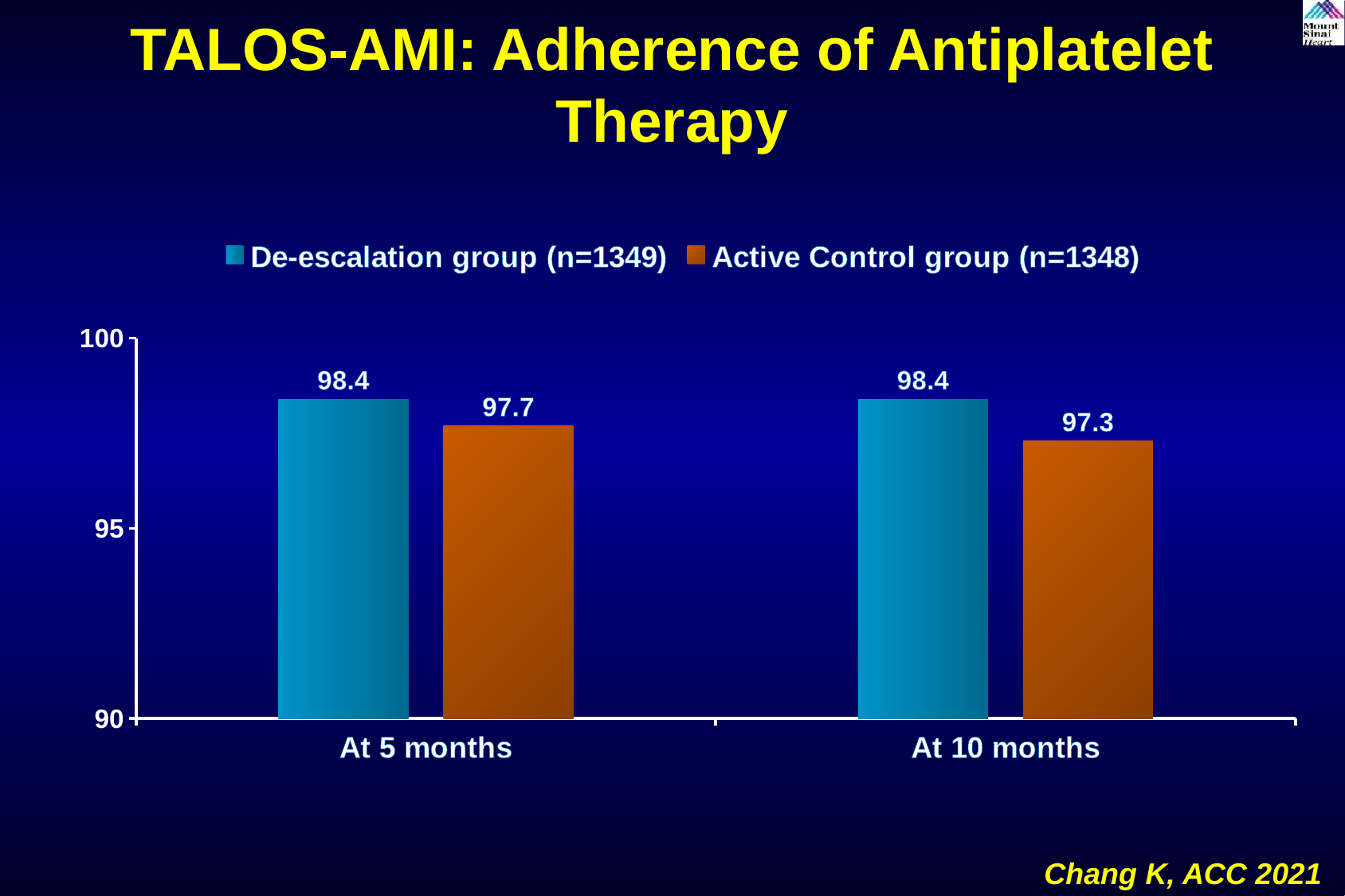
What is the value for the De-escalation group at 10 months? 98.4 What is the difference between the De-escalation group and the Active Control group at 5 months? 0.7 At 5 months, which group has the higher value, De-escalation or Active Control? De-escalation group Which bar has the lowest value on the chart? Active Control group at 10 months What kind of chart is shown on the slide? Bar chart How many time-point categories are shown on the x axis? 2 What is the value for the Active Control group at 10 months? 97.3 What is the difference between the De-escalation group and the Active Control group at 10 months? 1.1 What is the value for the De-escalation group at 5 months? 98.4 Is the value for the Active Control group at 10 months greater or less than 95? greater How many series does the legend list? 2 What is the value for the Active Control group at 5 months? 97.7